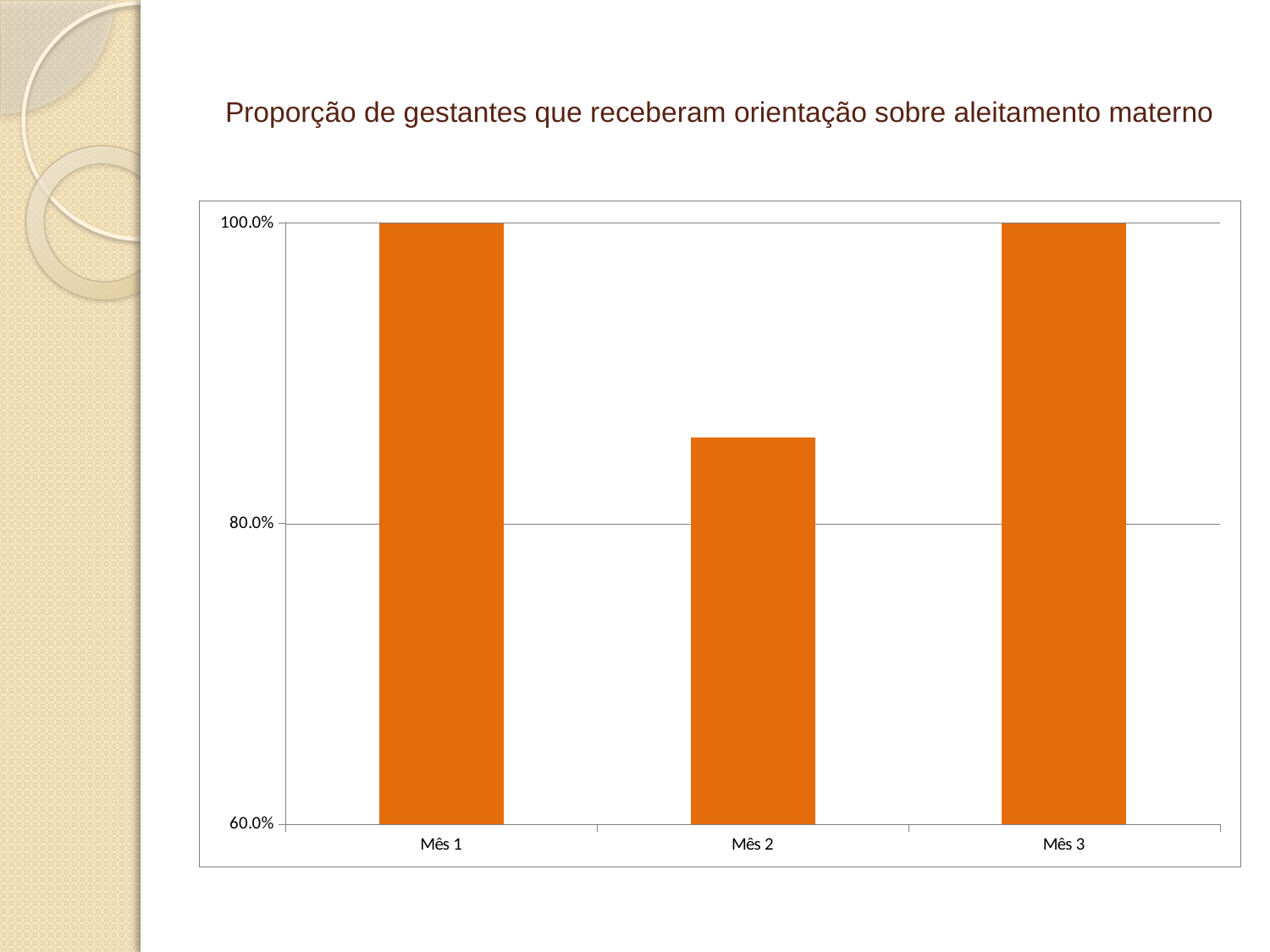
Which is larger, the value for Mês 1 or the value for Mês 2? Mês 1 Which is larger, the value for Mês 2 or the value for Mês 3? Mês 3 What kind of chart is shown on the slide? bar chart Does the value fall or rise from Mês 1 to Mês 2? fall Is the value for Mês 2 greater or less than 80.0%? greater What is the value for Mês 1? 100.0% What is the title of the chart? Proporção de gestantes que receberam orientação sobre aleitamento materno What is the lowest value shown on the y axis? 60.0% What is the value for Mês 3? 100.0% Is the value for Mês 2 greater or less than 100.0%? less How many months are shown on the x axis? 3 Which month has the lowest value? Mês 2